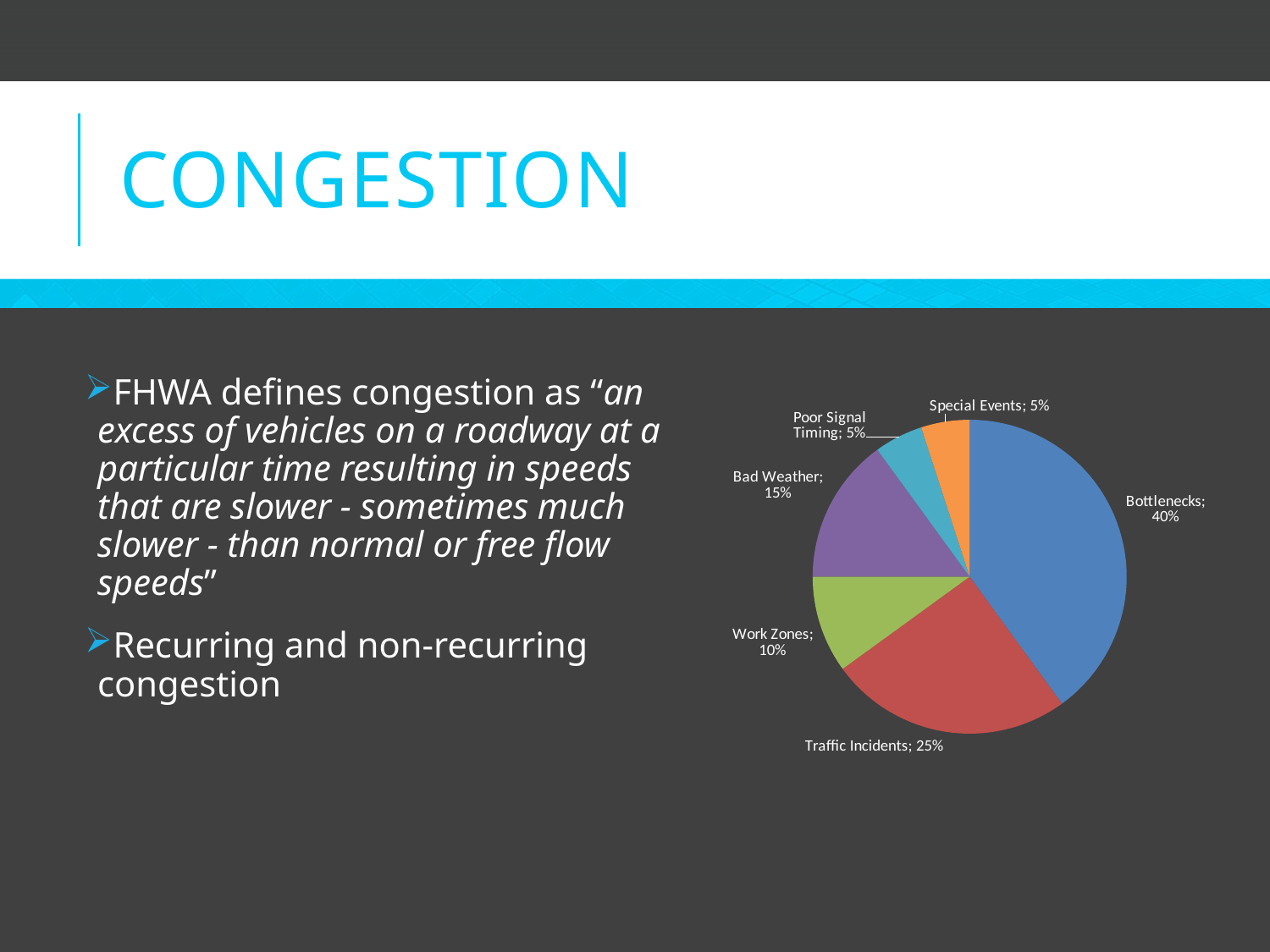
How many slices does the pie chart have? 6 What is the value for Work Zones? 10% What is the value for Bad Weather? 15% What share of the pie is Bottlenecks? 40% Which category has the largest slice of the pie? Bottlenecks What is the value for Traffic Incidents? 25% What kind of chart is shown on the slide? pie chart What colour is the Bottlenecks slice? blue Which is larger, Bad Weather or Work Zones? Bad Weather What is the difference between the Bottlenecks and Traffic Incidents shares? 15% Which two categories each have a 5% share? Poor Signal Timing and Special Events What is the difference between the Traffic Incidents and Special Events shares? 20%